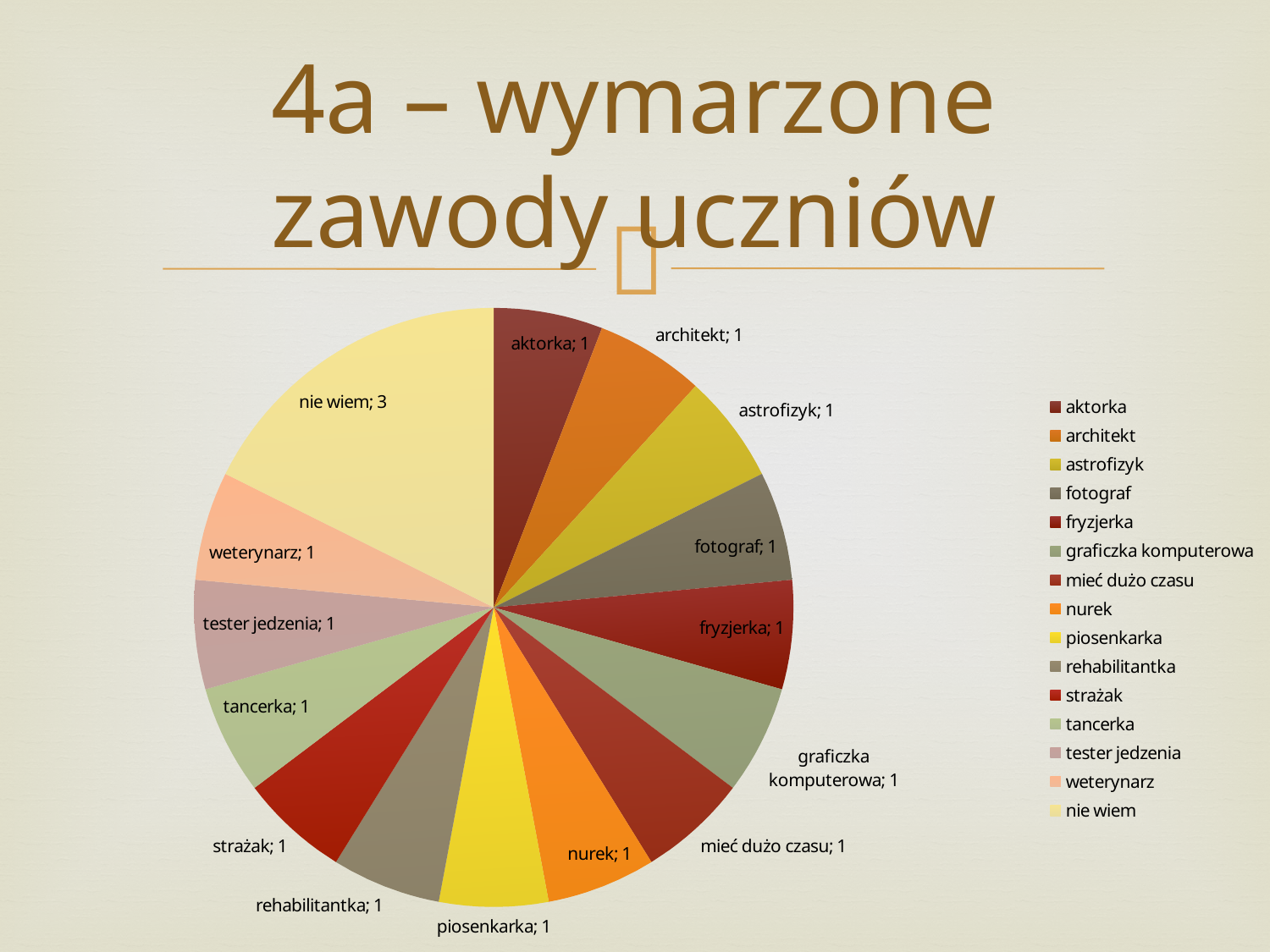
How many categories (slices) does the pie chart have? 15 What is the value for "nie wiem" in the pie chart? 3 What is the value for "graficzka komputerowa" in the pie chart? 1 How many entries does the legend list? 15 What is the difference between the value for "nie wiem" and the value for "strażak"? 2 What kind of chart is shown on the slide? pie chart What is the value for "aktorka" in the pie chart? 1 What is the title of the slide containing the pie chart? 4a – wymarzone zawody uczniów What is the value for "tester jedzenia" in the pie chart? 1 Which category has the largest slice in the pie chart? nie wiem Which category is listed last in the legend? nie wiem Which is larger, the value for "nie wiem" or the value for "weterynarz"? nie wiem